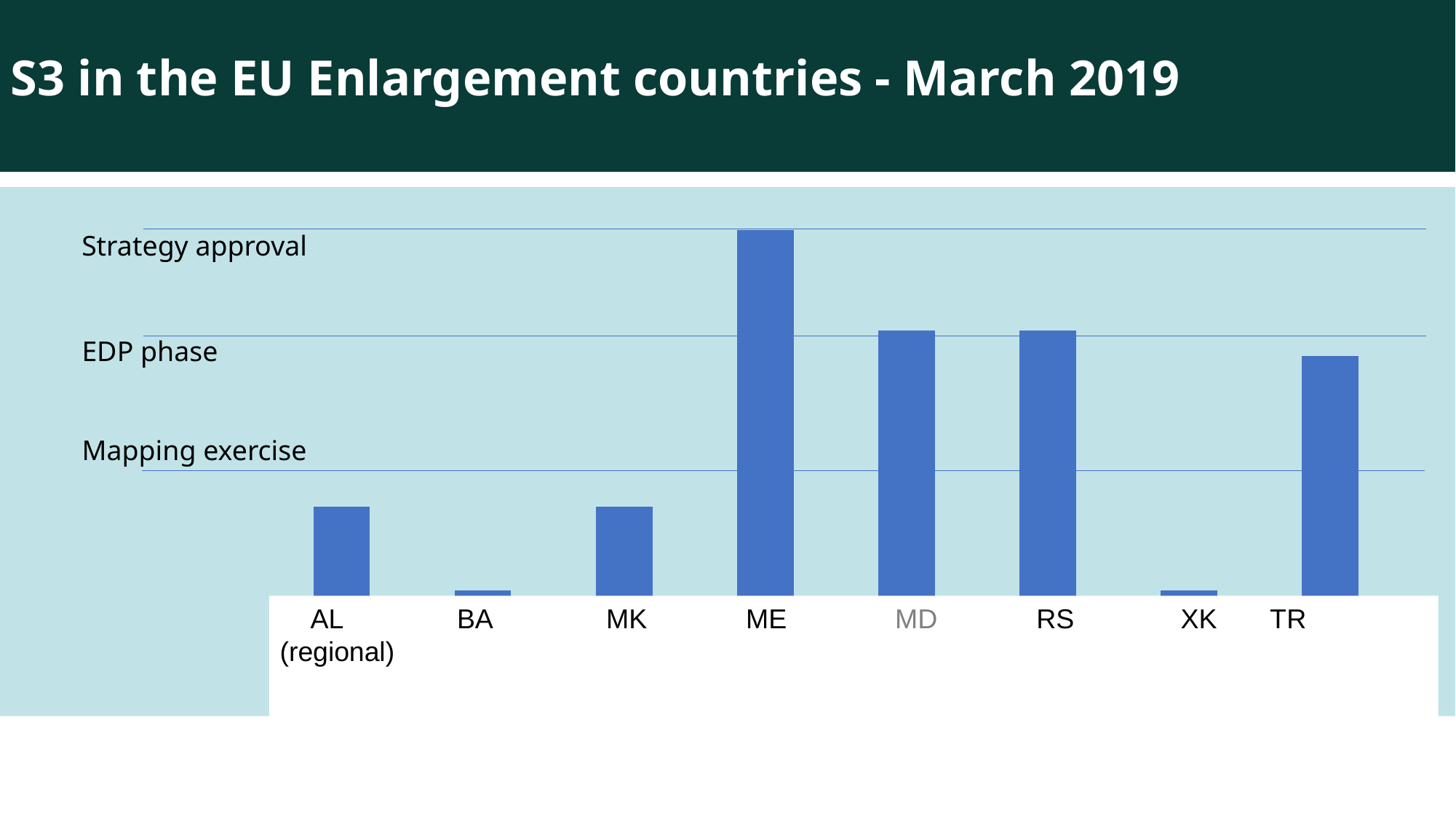
Which bar is taller, TR or XK? TR Which stage on the y axis does the bar for MD reach? EDP phase Which bar is taller, BA or MK? MK Which country has the highest bar in the chart? ME What are the three stage labels shown on the y axis of the chart, from bottom to top? Mapping exercise, EDP phase, Strategy approval How many countries (categories) are shown on the x axis of the chart? 8 Which bar is taller, ME or TR? ME Which stage on the y axis does the bar for ME reach? Strategy approval What is the title of the chart on the slide? S3 in the EU Enlargement countries - March 2019 What kind of chart is shown on the slide? Bar chart Which stage on the y axis does the bar for RS reach? EDP phase